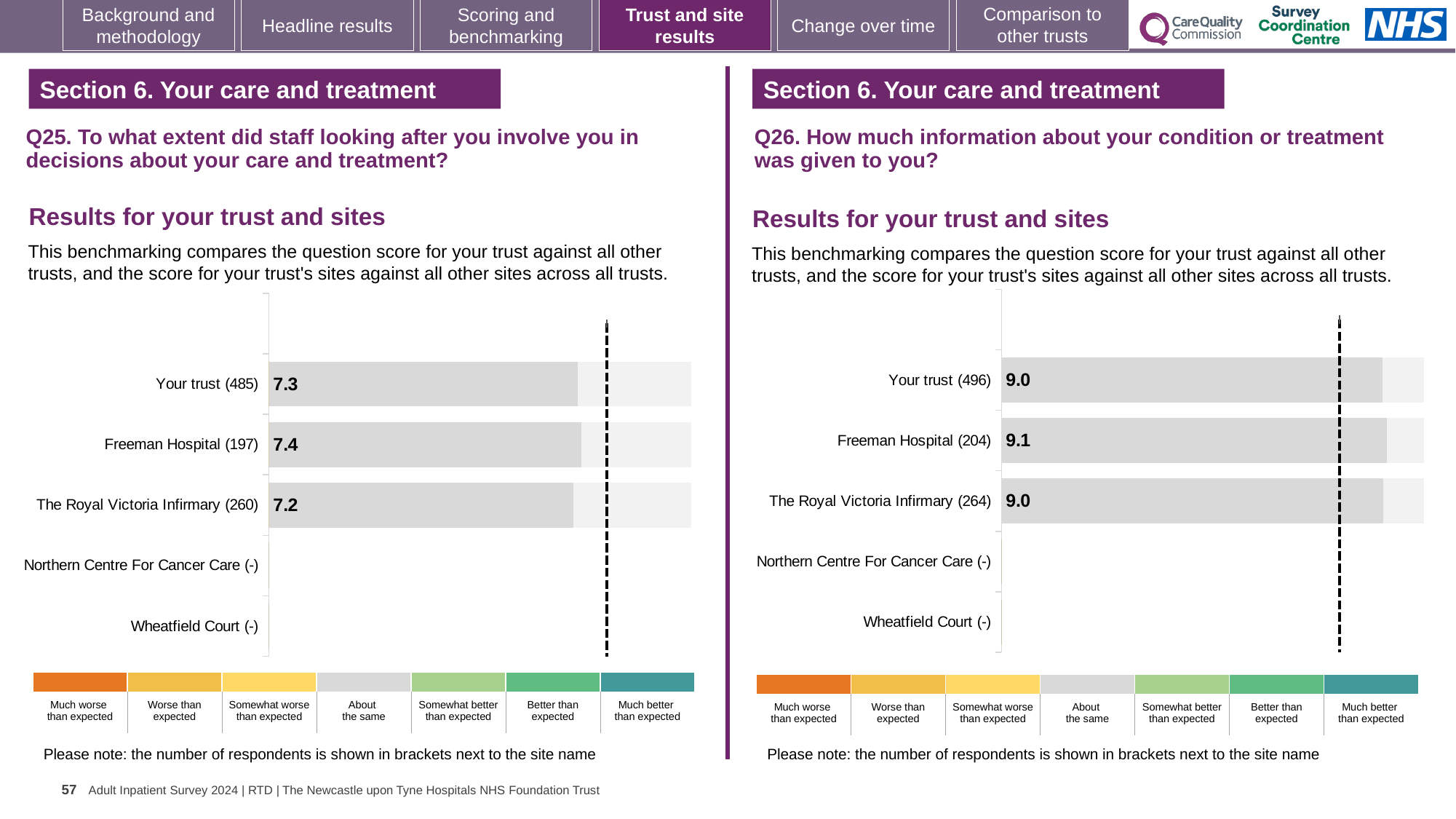
In the Q26 chart on the right, what is the score for Your trust? 9.0 In the Q25 chart on the left, what is the score for Your trust? 7.3 In the Q26 chart on the right, what is the difference between the Freeman Hospital score and the Your trust score? 0.1 In the Q26 chart on the right, what is the score for The Royal Victoria Infirmary? 9.0 In the Q25 chart on the left, how many respondents are shown in brackets for Your trust? 485 In the Q25 chart on the left, what is the difference between the Freeman Hospital score and The Royal Victoria Infirmary score? 0.2 In the Q25 chart on the left, what is the score for Freeman Hospital? 7.4 In the Q25 chart on the left, which site with a plotted score has the highest value? Freeman Hospital How many site or trust rows are listed on the y axis of the Q26 chart on the right? 5 In the Q25 chart on the left, what is the score for The Royal Victoria Infirmary? 7.2 What type of chart is used for the Q25 results on the left? Bar chart In the Q26 chart on the right, what is the score for Freeman Hospital? 9.1